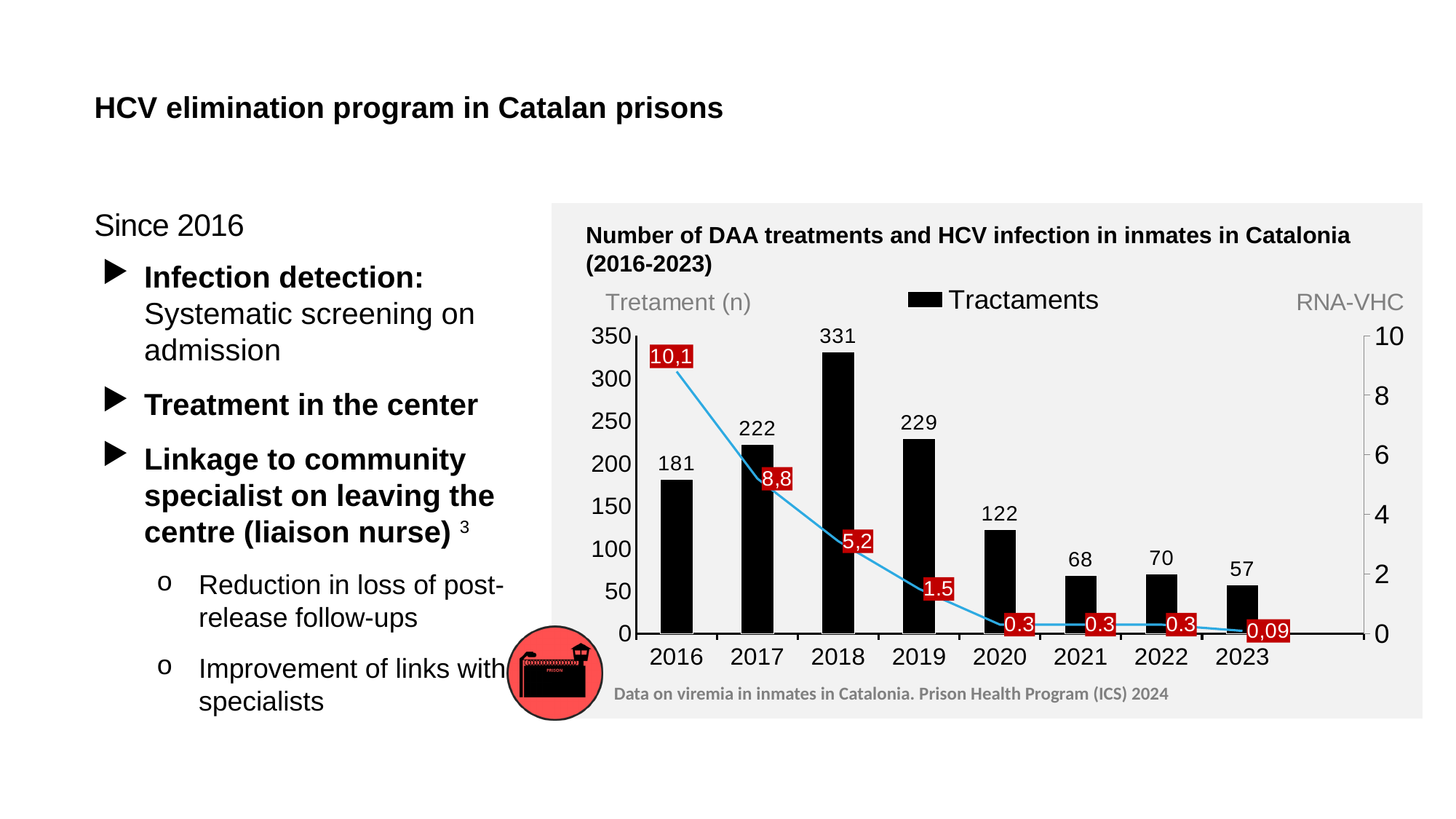
How many treatments are shown for 2021? 68 How many years are shown on the x axis? 8 What is the RNA-VHC value shown for 2023? 0,09 How many DAA treatments (Tractaments) were given in 2018? 331 What is the difference between the number of treatments in 2018 and in 2017? 109 Which year has the lowest number of treatments? 2023 What kind of chart is used to show the treatments? Bar chart (with a line for RNA-VHC) Does the RNA-VHC line rise or fall from 2016 to 2023? Fall Which year has the highest number of treatments? 2018 What is the RNA-VHC value shown for 2016? 10,1 Which year had more treatments, 2017 or 2019? 2019 What is the title of the chart? Number of DAA treatments and HCV infection in inmates in Catalonia (2016-2023)